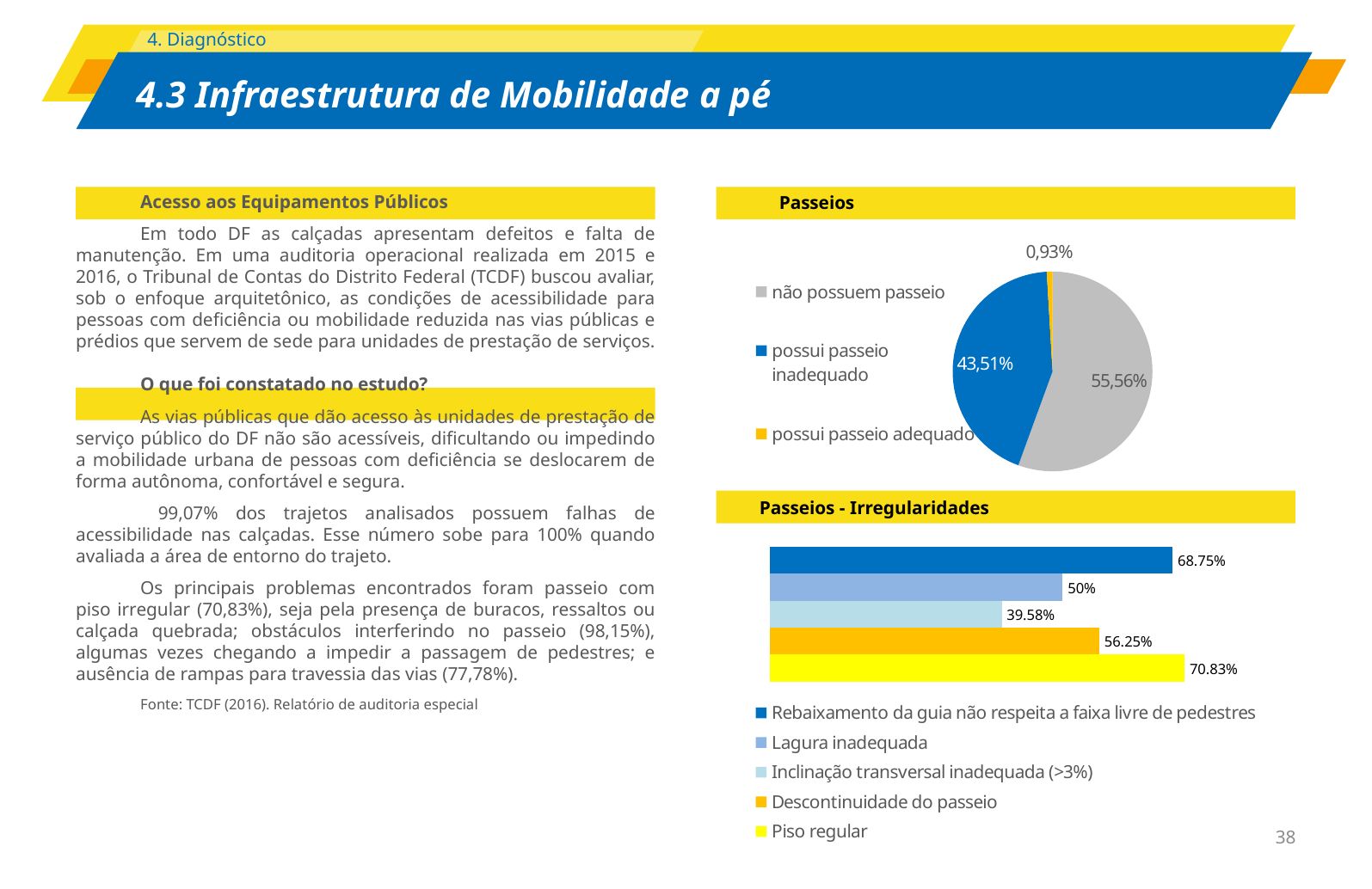
In the 'Passeios - Irregularidades' chart, which is larger: 'Descontinuidade do passeio' or 'Lagura inadequada'? Descontinuidade do passeio In the 'Passeios' pie chart, what share is labelled for 'possui passeio inadequado'? 43,51% In the 'Passeios - Irregularidades' chart, which category has the highest value? Piso regular In the 'Passeios' pie chart, which category has the largest slice? não possuem passeio In the 'Passeios - Irregularidades' chart, what is the value for 'Piso regular'? 70.83% In the 'Passeios - Irregularidades' chart, what is the difference between 'Rebaixamento da guia não respeita a faixa livre de pedestres' and 'Lagura inadequada'? 18.75% How many slices does the 'Passeios' pie chart have? 3 What type of chart is the 'Passeios' chart? pie chart In the 'Passeios' pie chart, what share is labelled for 'não possuem passeio'? 55,56% In the 'Passeios - Irregularidades' chart, what is the value for 'Inclinação transversal inadequada (>3%)'? 39.58% What type of chart is the 'Passeios - Irregularidades' chart? bar chart In the 'Passeios' pie chart, which category has the smallest slice? possui passeio adequado